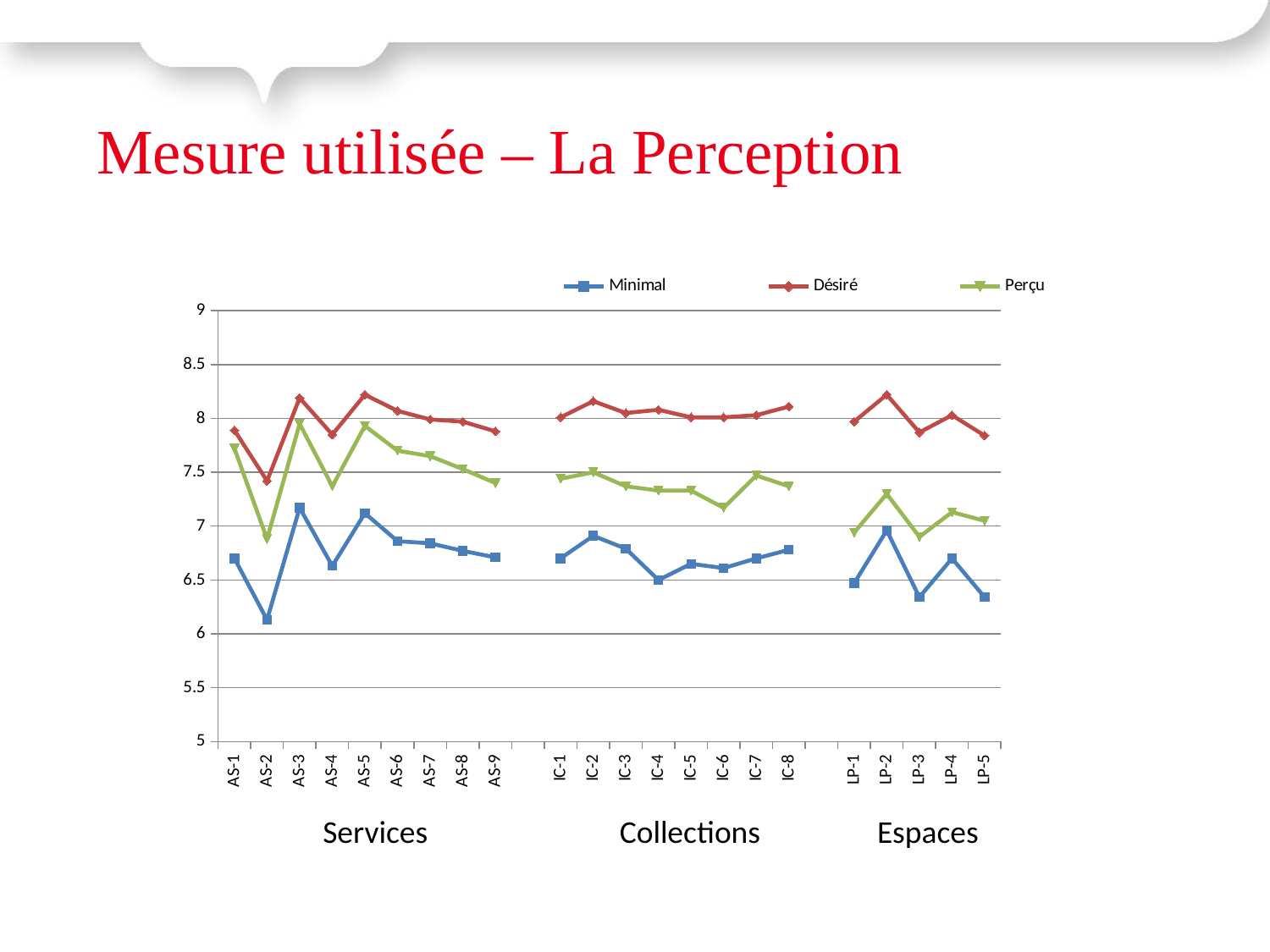
Is the value for Désiré at IC-2 greater or less than 8? greater Is the value for Minimal at AS-2 greater or less than 6.5? less Which is larger at LP-3: the Désiré value or the Perçu value? Désiré Is the value for Perçu at IC-6 greater or less than 7.5? less Which category has the lowest value for the Minimal series? AS-2 Which category has the highest value for the Minimal series? AS-3 Does the Minimal series rise or fall from IC-2 to IC-4? fall What kind of chart is shown on the slide? line chart How many categories are plotted along the x axis? 22 What are the three group labels shown below the x axis? Services, Collections, Espaces Which category has the lowest value for the Désiré series? AS-2 How many series does the legend list? 3